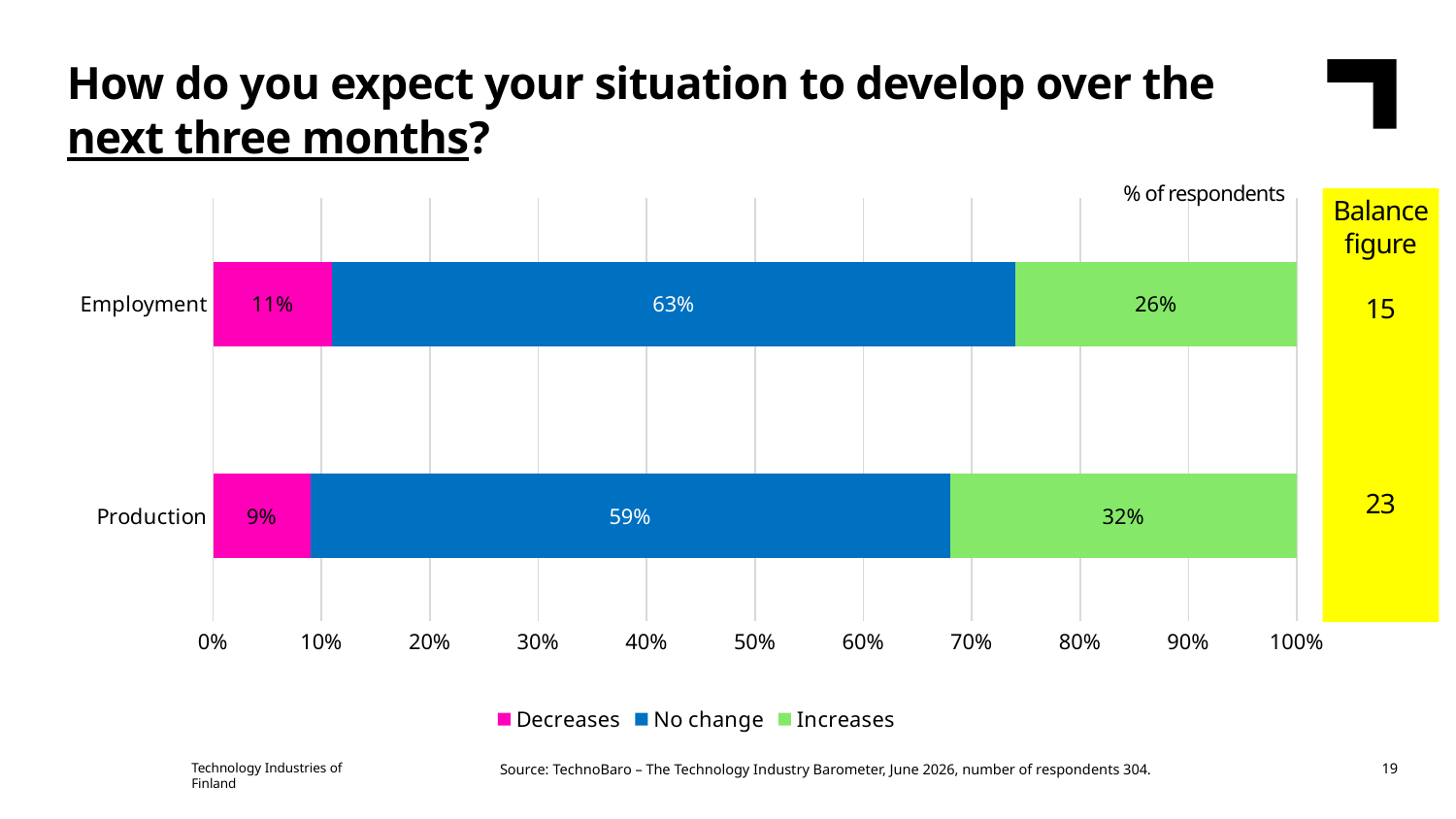
What is the difference in percentage points between the 'Increases' share for Production and for Employment? 6 percentage points What percentage of respondents expect production to increase over the next three months? 32% What is the balance figure for Employment? 15 What kind of chart is shown on the slide? Stacked bar chart What percentage of respondents expect employment to show no change over the next three months? 63% Which colour represents 'Decreases' in the chart? Pink (magenta) How many series does the legend list? 3 Which category has the larger share of respondents expecting increases, Employment or Production? Production What is the balance figure for Production? 23 What percentage of respondents expect employment to decrease? 11% What percentage of respondents expect production to decrease? 9% How many categories are shown on the chart? 2